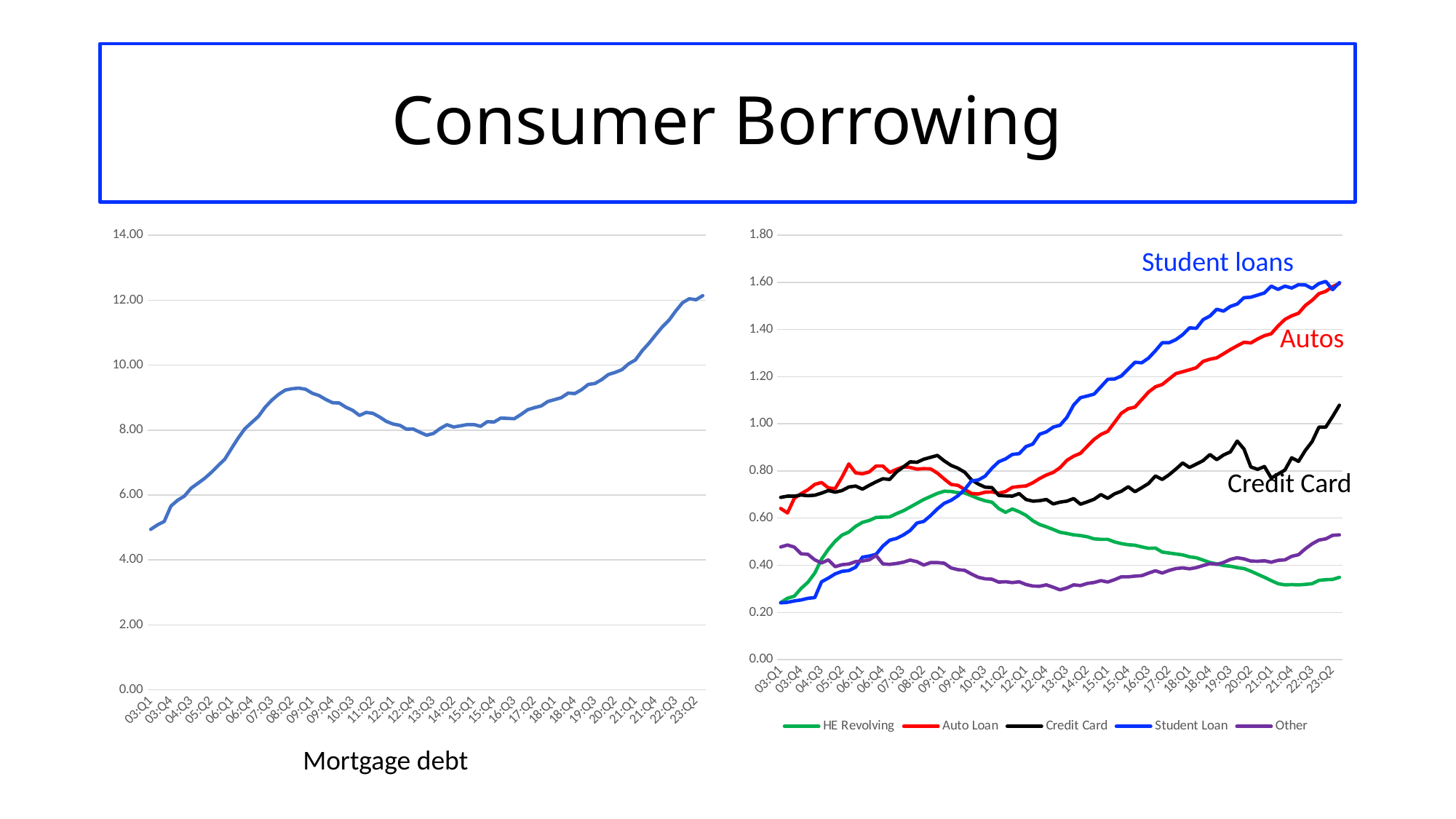
In the right-hand chart, what colour is the Student Loan line? Blue What kind of chart is the Mortgage debt chart on the left? Line chart In the Mortgage debt chart on the left, does the line overall rise or fall from 03:Q1 to 23:Q2? Rise In the Mortgage debt chart on the left, is the value for 03:Q1 greater or less than 6.00? less How many series does the legend of the right-hand chart list? 5 In the Mortgage debt chart on the left, is the value for 09:Q1 greater or less than 8.00? greater In the right-hand chart, at 23:Q2, which is larger: Credit Card or Other? Credit Card In the Mortgage debt chart on the left, is the value for 23:Q2 greater or less than 10.00? greater In the right-hand chart, which series has the lowest value at 23:Q2? HE Revolving In the right-hand chart, which series has the highest value at 03:Q1? Credit Card